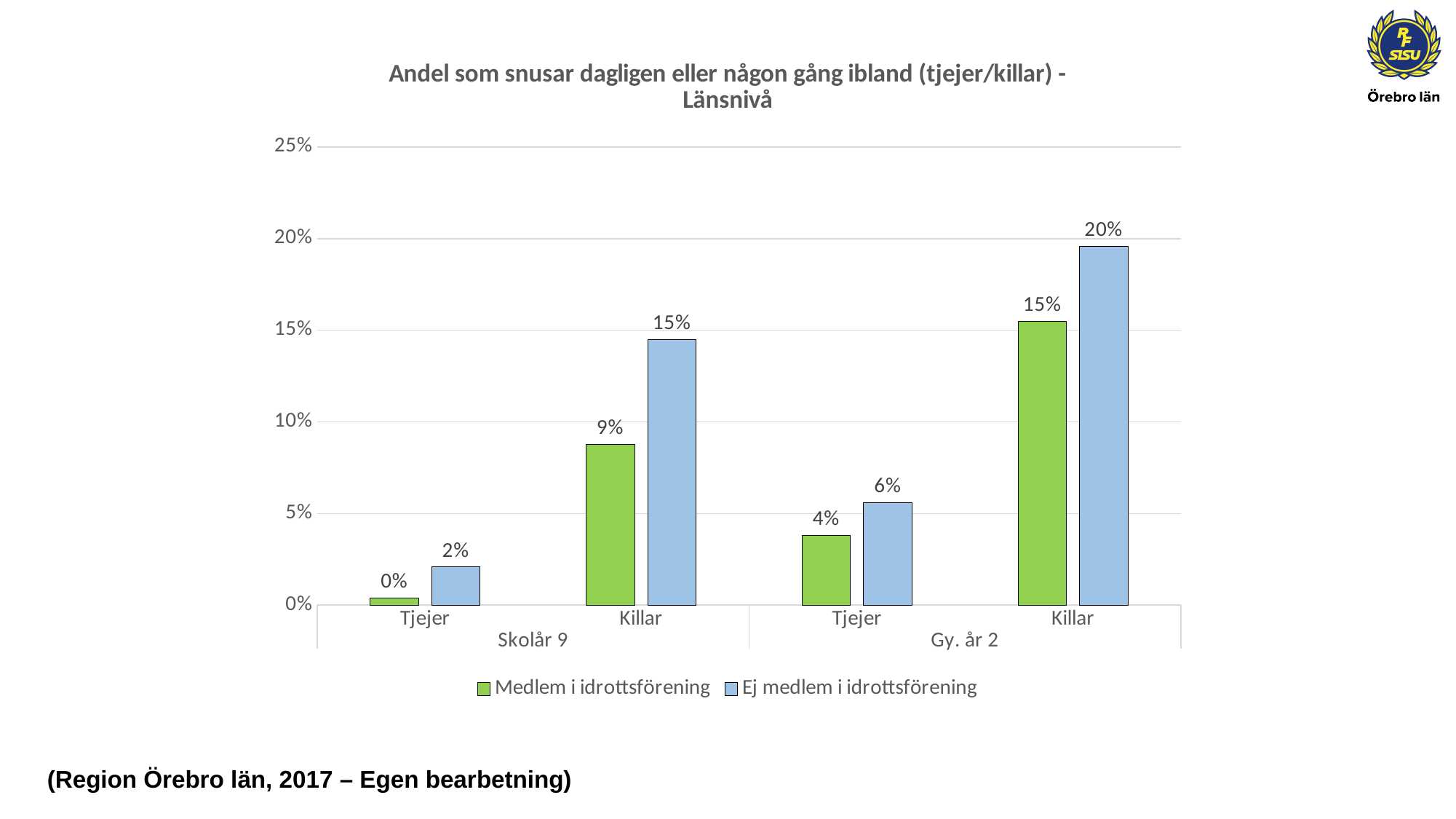
What is the value for Tjejer in Skolår 9 for the series Ej medlem i idrottsförening? 2% Which group has the lowest value in the chart? Tjejer, Skolår 9 (Medlem i idrottsförening) Which is larger for Killar in Gy. år 2: Medlem i idrottsförening or Ej medlem i idrottsförening? Ej medlem i idrottsförening Is the value for Killar in Skolår 9 for Medlem i idrottsförening greater or less than 10%? less What kind of chart is shown on the slide? Bar chart What is the difference between the Ej medlem i idrottsförening and Medlem i idrottsförening values for Killar in Skolår 9? 6 percentage points What is the value for Killar in Gy. år 2 for the series Ej medlem i idrottsförening? 20% What is the value for Killar in Skolår 9 for the series Ej medlem i idrottsförening? 15% What colour represents the series Medlem i idrottsförening? Green How many series does the legend list? 2 What is the value for Tjejer in Gy. år 2 for the series Medlem i idrottsförening? 4% Which group has the highest value in the chart? Killar, Gy. år 2 (Ej medlem i idrottsförening)